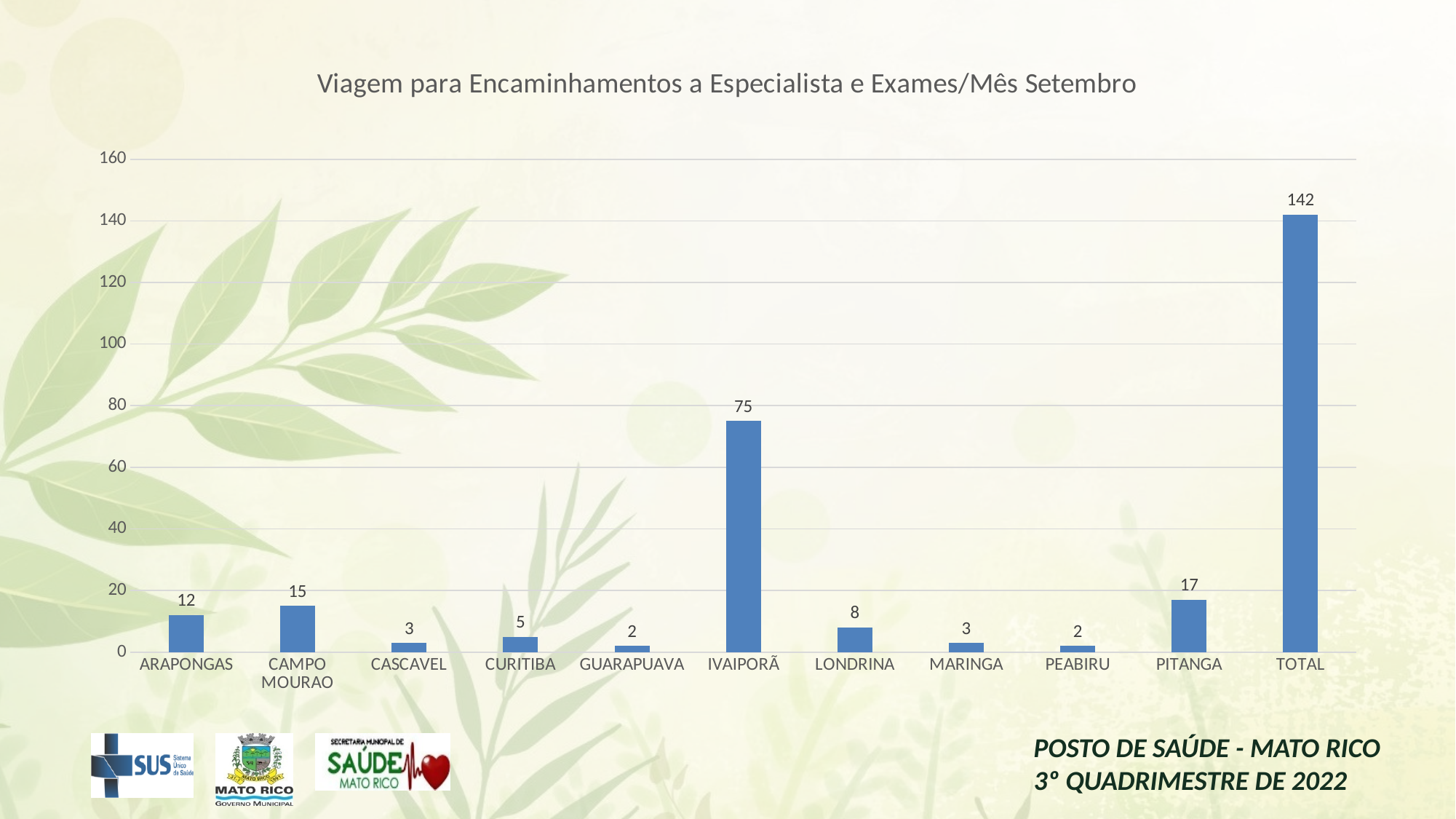
Excluding the TOTAL bar, which city has the highest value? IVAIPORÃ Which categories have the lowest value? GUARAPUAVA and PEABIRU Is the value for IVAIPORÃ greater or less than 60? greater What is the title of the chart? Viagem para Encaminhamentos a Especialista e Exames/Mês Setembro Which is larger, the value for ARAPONGAS or the value for CAMPO MOURAO? CAMPO MOURAO What is the value for PITANGA? 17 What is the value for CAMPO MOURAO? 15 What is the value shown for TOTAL? 142 How many bars are shown in the chart, including TOTAL? 11 What kind of chart is shown on the slide? bar chart What is the value for IVAIPORÃ? 75 What is the difference between the values for IVAIPORÃ and LONDRINA? 67